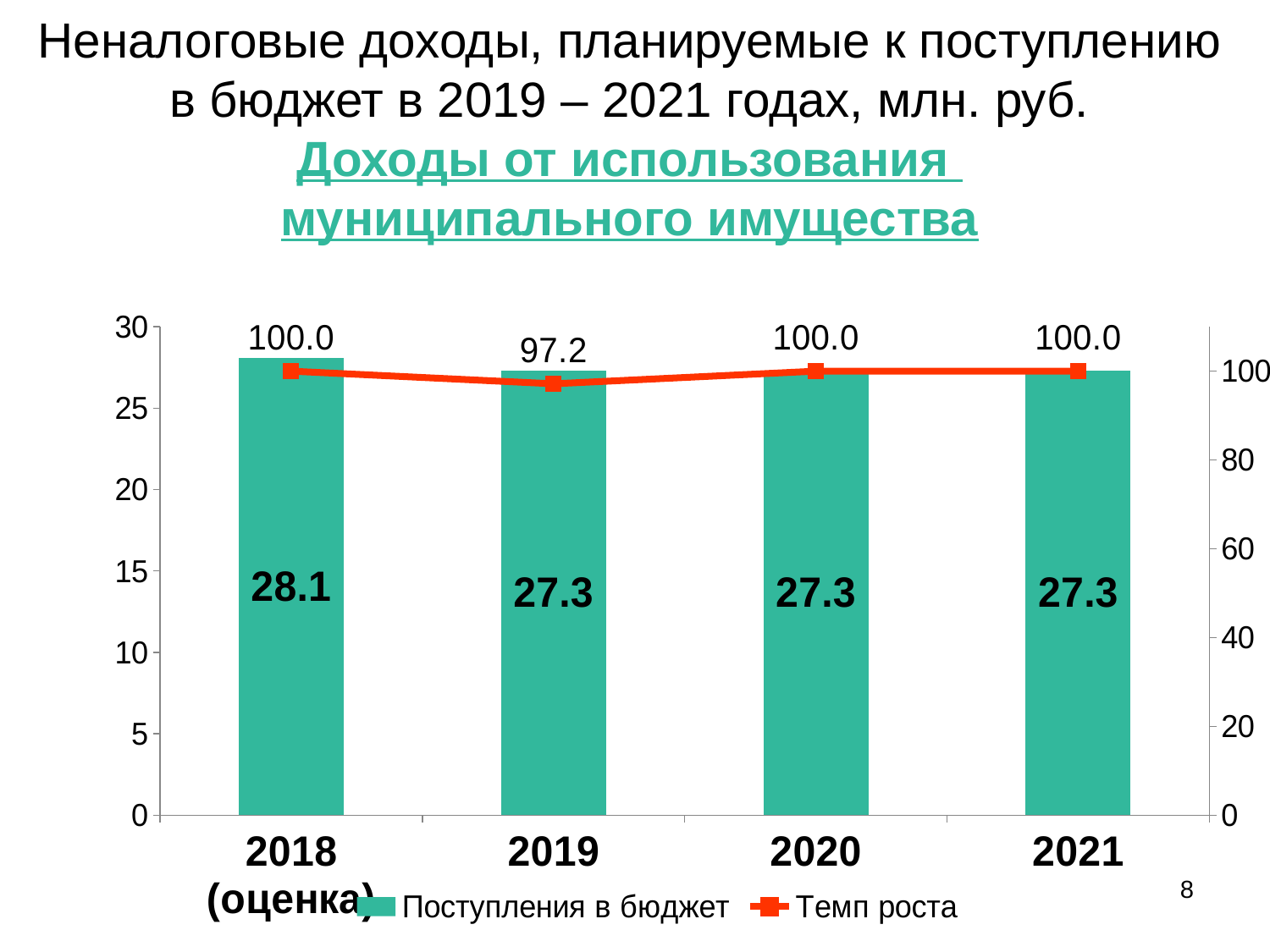
What is the 'Темп роста' value for 2019? 97.2 What is the 'Темп роста' value for 2021? 100.0 How many years are shown on the x axis? 4 How many series does the legend list? 2 Do the 'Поступления в бюджет' values rise or fall from 2018 (оценка) to 2019? Fall Which year has the highest value of 'Поступления в бюджет'? 2018 (оценка) What is the difference between 'Поступления в бюджет' in 2018 (оценка) and 2019? 0.8 Which is larger: 'Поступления в бюджет' in 2018 (оценка) or in 2021? 2018 (оценка) What is the value of 'Поступления в бюджет' for 2018 (оценка)? 28.1 What kind of chart is used for the 'Поступления в бюджет' series? Bar chart What is the value of 'Поступления в бюджет' for 2020? 27.3 Which year has the lowest 'Темп роста' value? 2019